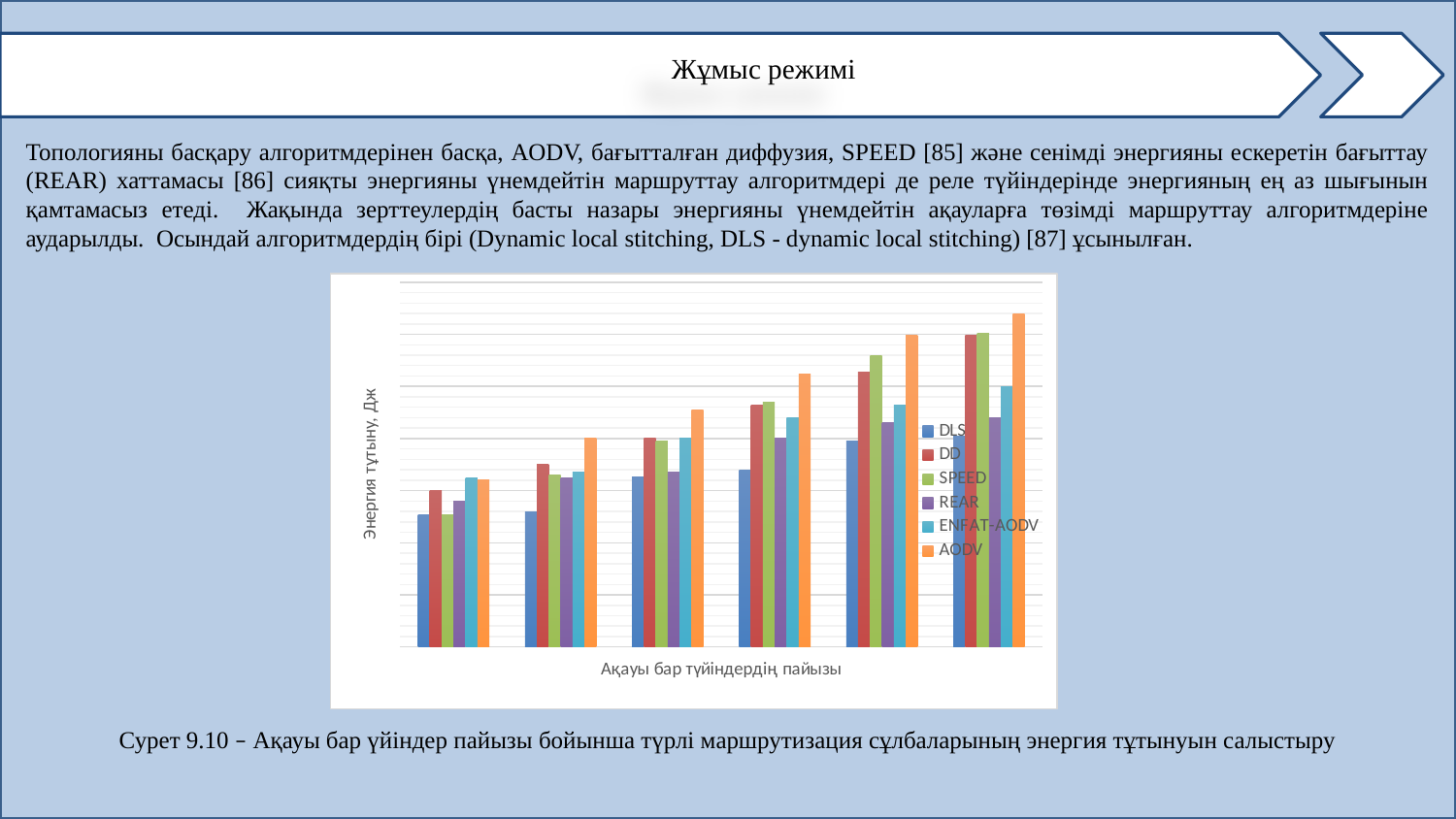
In the second group of bars from the left, which is larger: the DD bar or the DLS bar? DD In the rightmost group of bars, which is larger: the AODV bar or the DLS bar? AODV Do the AODV values rise or fall from left to right along the x axis? rise In the rightmost group of bars, which series has the tallest bar? AODV In the rightmost group of bars, which is larger: the DD bar or the REAR bar? DD What type of chart is shown on the slide? bar chart Do the DD values rise or fall from left to right along the x axis? rise What is the title of the vertical axis of the chart? Энергия тұтыну, Дж How many series does the chart legend list? 6 Which series is listed first in the chart legend? DLS How many groups of bars are plotted along the x axis? 6